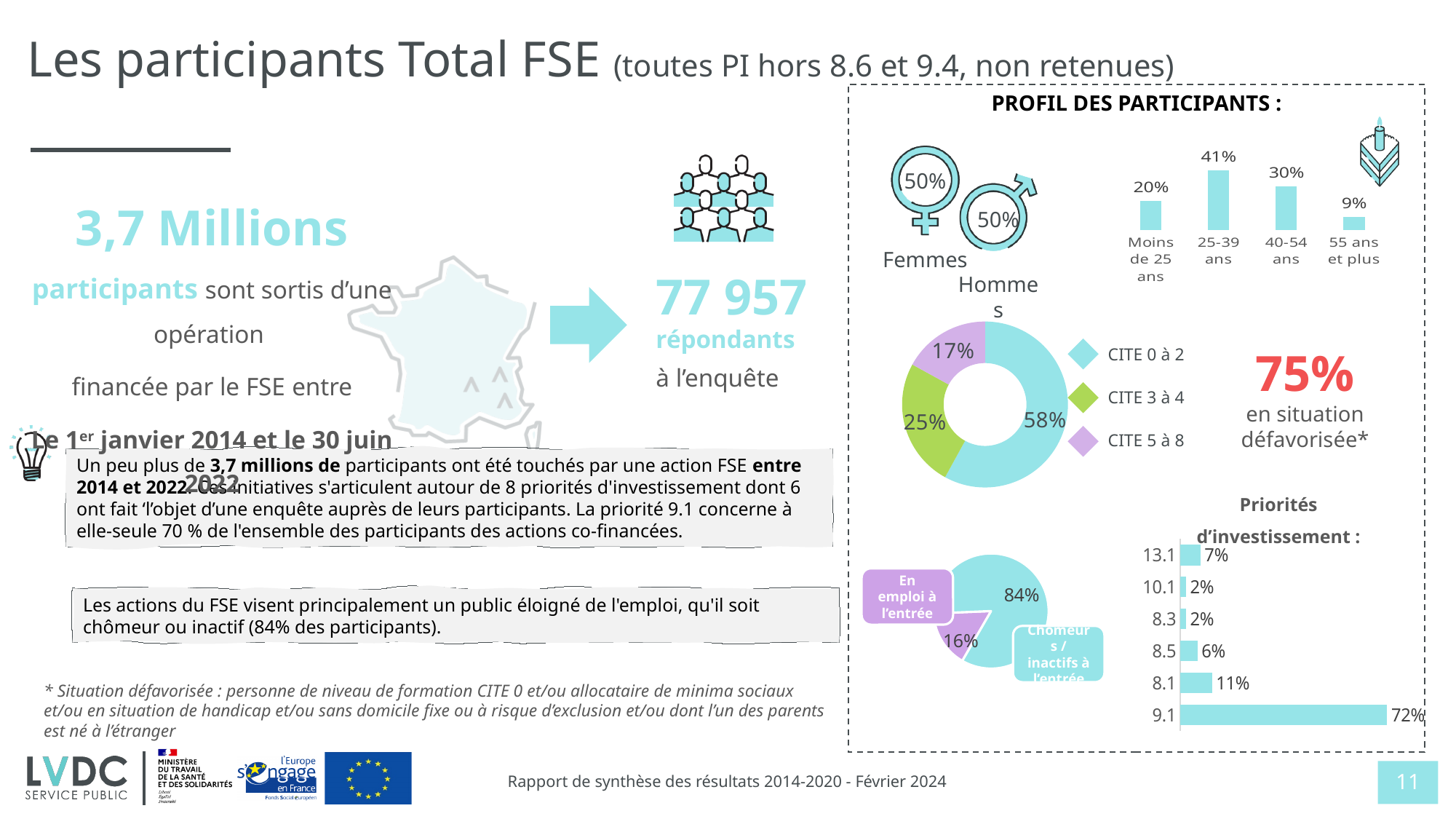
How many entries does the legend of the CITE donut chart list? 3 What kind of chart is the 'Priorités d'investissement' chart? Bar chart In the age bar chart at the top right, what is the value for '25-39 ans'? 41% In the 'Priorités d'investissement' bar chart, what is the value for 9.1? 72% In the pie chart at the bottom of the profile panel, what is the share for 'Chômeurs / inactifs à l'entrée'? 84% In the CITE donut chart, what is the share for 'CITE 3 à 4'? 25% In the age bar chart at the top right, which age group has the lowest value? 55 ans et plus In the age bar chart at the top right, what is the difference between '40-54 ans' and 'Moins de 25 ans'? 10% In the 'Priorités d'investissement' bar chart, which is larger, 8.1 or 8.5? 8.1 In the CITE donut chart, which category has the largest share? CITE 0 à 2 How many age groups are shown in the age bar chart at the top right? 4 In the age bar chart at the top right, which age group has the highest value? 25-39 ans